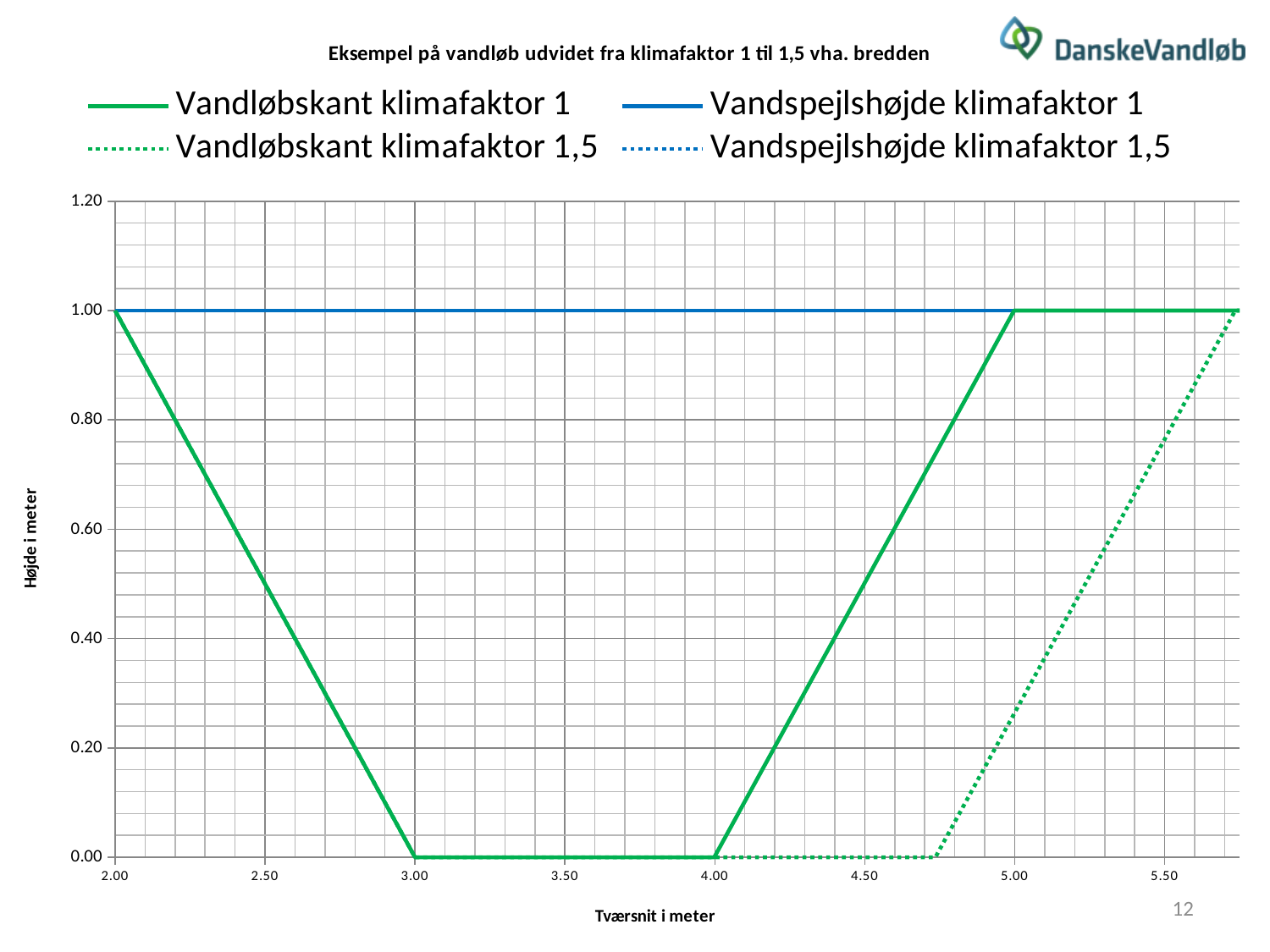
What is the label of the vertical axis? Højde i meter Is the value for Vandløbskant klimafaktor 1,5 at 5.00 meters greater or less than 0.60? less What kind of chart is shown on the slide? Line chart What is the value of Vandspejlshøjde klimafaktor 1 at a cross-section of 3.00 meters? 1.00 How many series does the legend list? 4 Does Vandløbskant klimafaktor 1,5 rise or fall between 5.00 and 5.50 meters on the x axis? Rise At a cross-section of 4.50 meters, which is larger: Vandløbskant klimafaktor 1 or Vandløbskant klimafaktor 1,5? Vandløbskant klimafaktor 1 What is the value of Vandløbskant klimafaktor 1 at a cross-section of 2.00 meters? 1.00 What is the value of Vandløbskant klimafaktor 1 at a cross-section of 5.00 meters? 1.00 Does Vandløbskant klimafaktor 1 rise or fall between 2.00 and 3.00 meters on the x axis? Fall What is the value of Vandløbskant klimafaktor 1 at a cross-section of 3.00 meters? 0.00 What is the title of the chart? Eksempel på vandløb udvidet fra klimafaktor 1 til 1,5 vha. bredden